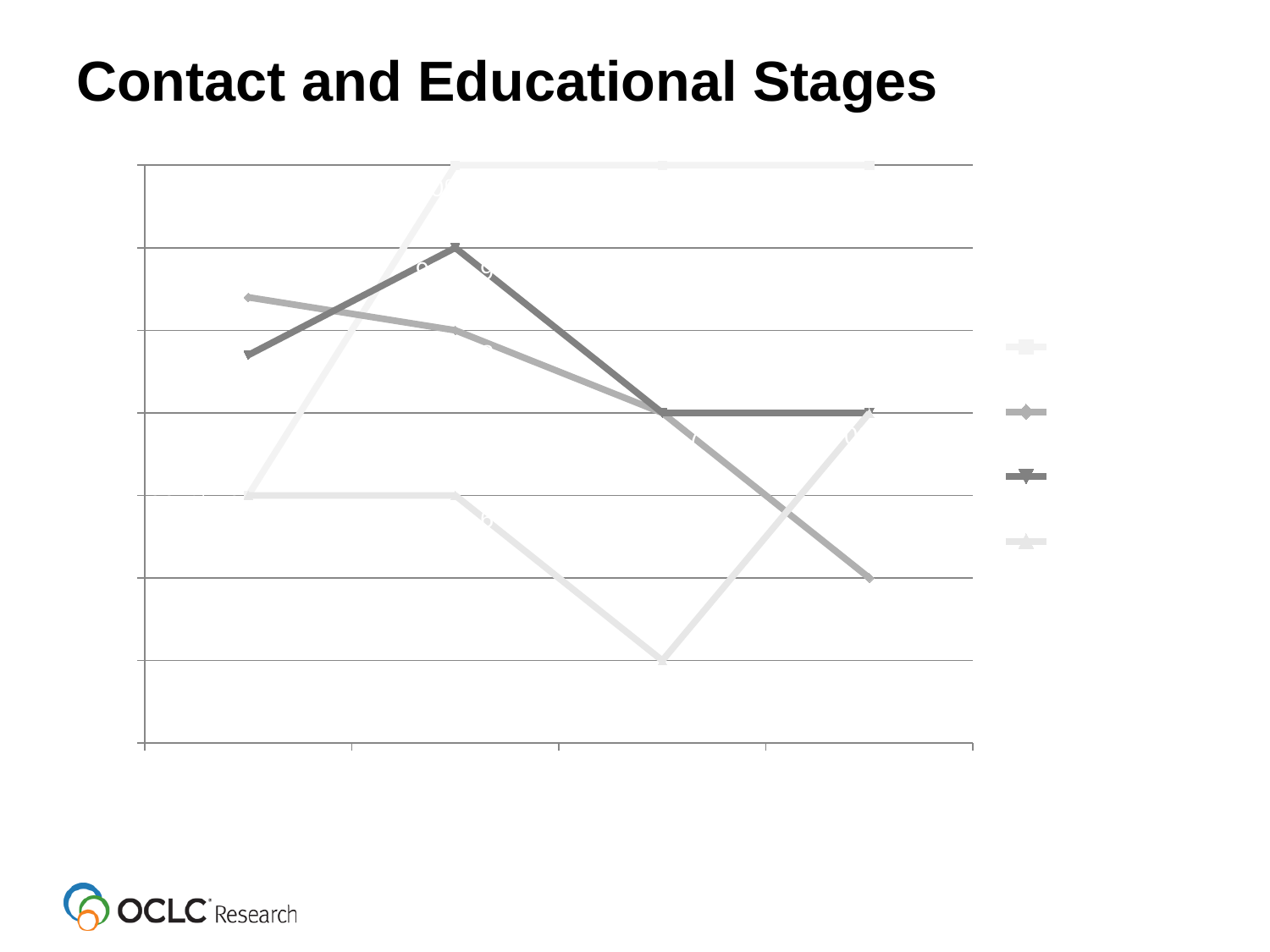
Does the medium-grey line with diamond markers rise or fall from the first point to the last point? fall How many lines are plotted on the chart? 4 How many series does the legend list? 4 How many points along the x axis does each line have? 4 What kind of chart is shown on the slide? line chart What is the title of the slide containing the chart? Contact and Educational Stages